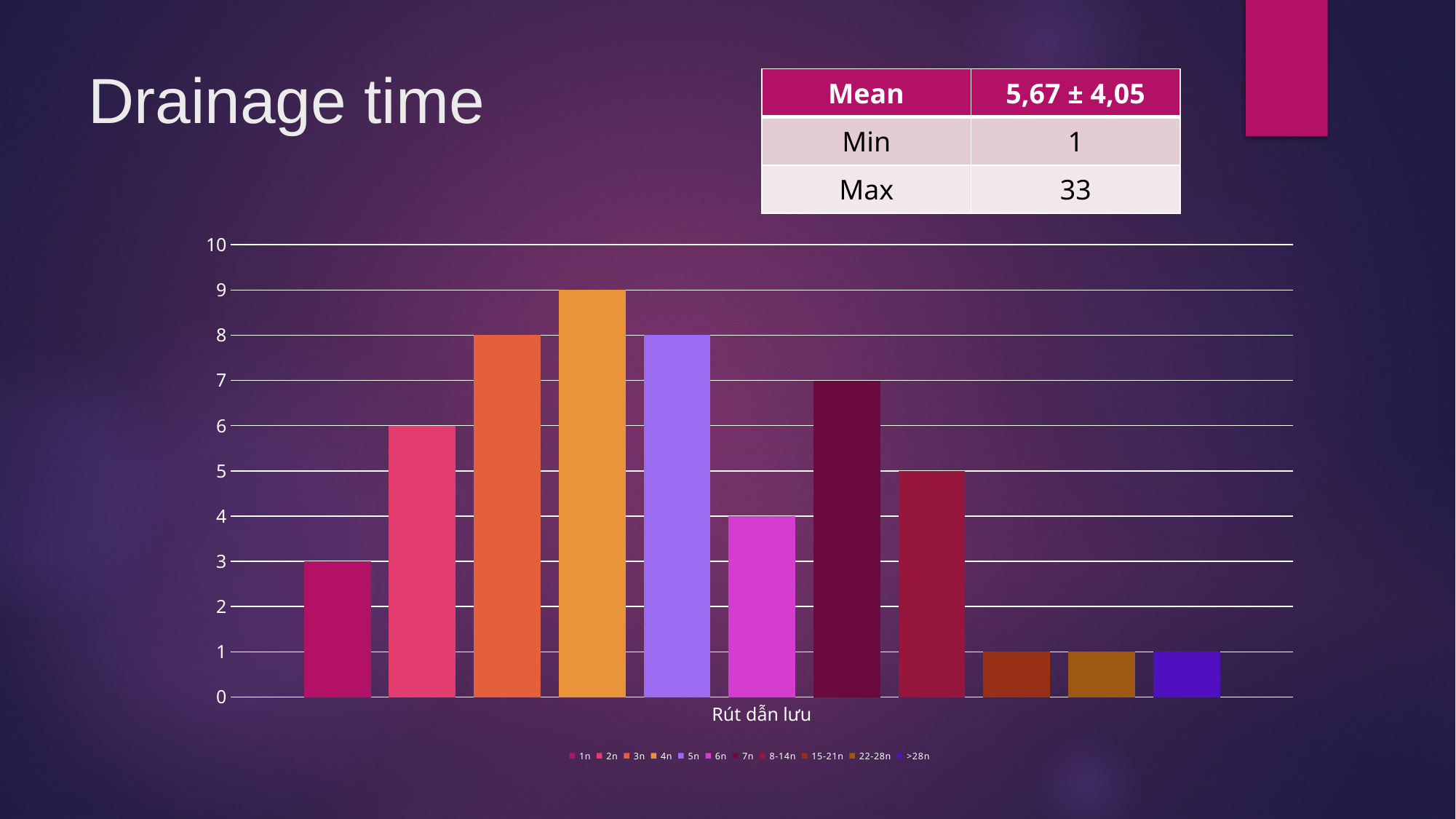
What is the value of the 4n bar? 9 Which series has the highest bar? 4n Which is larger, the 2n bar or the 8-14n bar? 2n What is the Max value shown in the table on the slide? 33 What kind of chart is shown on the slide? bar chart What is the value of the 7n bar? 7 What is the value of the 1n bar? 3 Is the value of the 5n bar greater or less than 5? greater What is the value of the >28n bar? 1 What is the category label shown on the x axis? Rút dẫn lưu What is the difference between the 3n bar and the 6n bar? 4 How many series does the chart legend list? 11